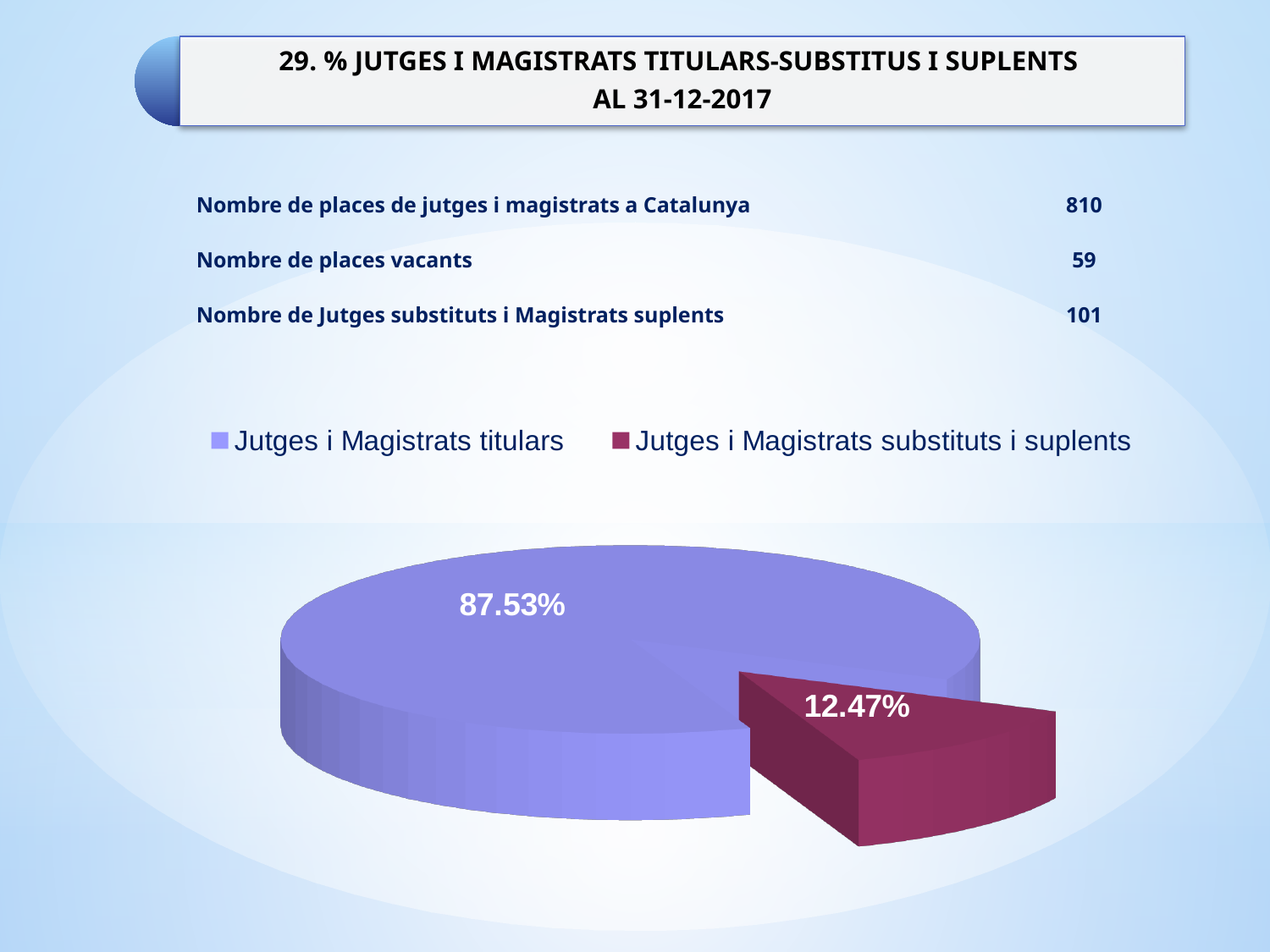
What is the title of the slide containing the pie chart? 29. % JUTGES I MAGISTRATS TITULARS-SUBSTITUS I SUPLENTS AL 31-12-2017 What percentage of the pie chart corresponds to Jutges i Magistrats substituts i suplents? 12.47% How many entries does the chart legend list? 2 Which slice is larger: Jutges i Magistrats titulars or Jutges i Magistrats substituts i suplents? Jutges i Magistrats titulars Which category has the smallest share of the pie chart? Jutges i Magistrats substituts i suplents What is the difference in percentage points between the Jutges i Magistrats titulars slice and the Jutges i Magistrats substituts i suplents slice? 75.06% What is the share of the pie taken by the Jutges i Magistrats substituts i suplents slice? 12.47% What percentage of the pie chart corresponds to Jutges i Magistrats titulars? 87.53% How many slices does the pie chart have? 2 Which category has the largest share of the pie chart? Jutges i Magistrats titulars What type of chart is shown on the slide? Pie chart What colour is the slice for Jutges i Magistrats substituts i suplents? Dark red / magenta